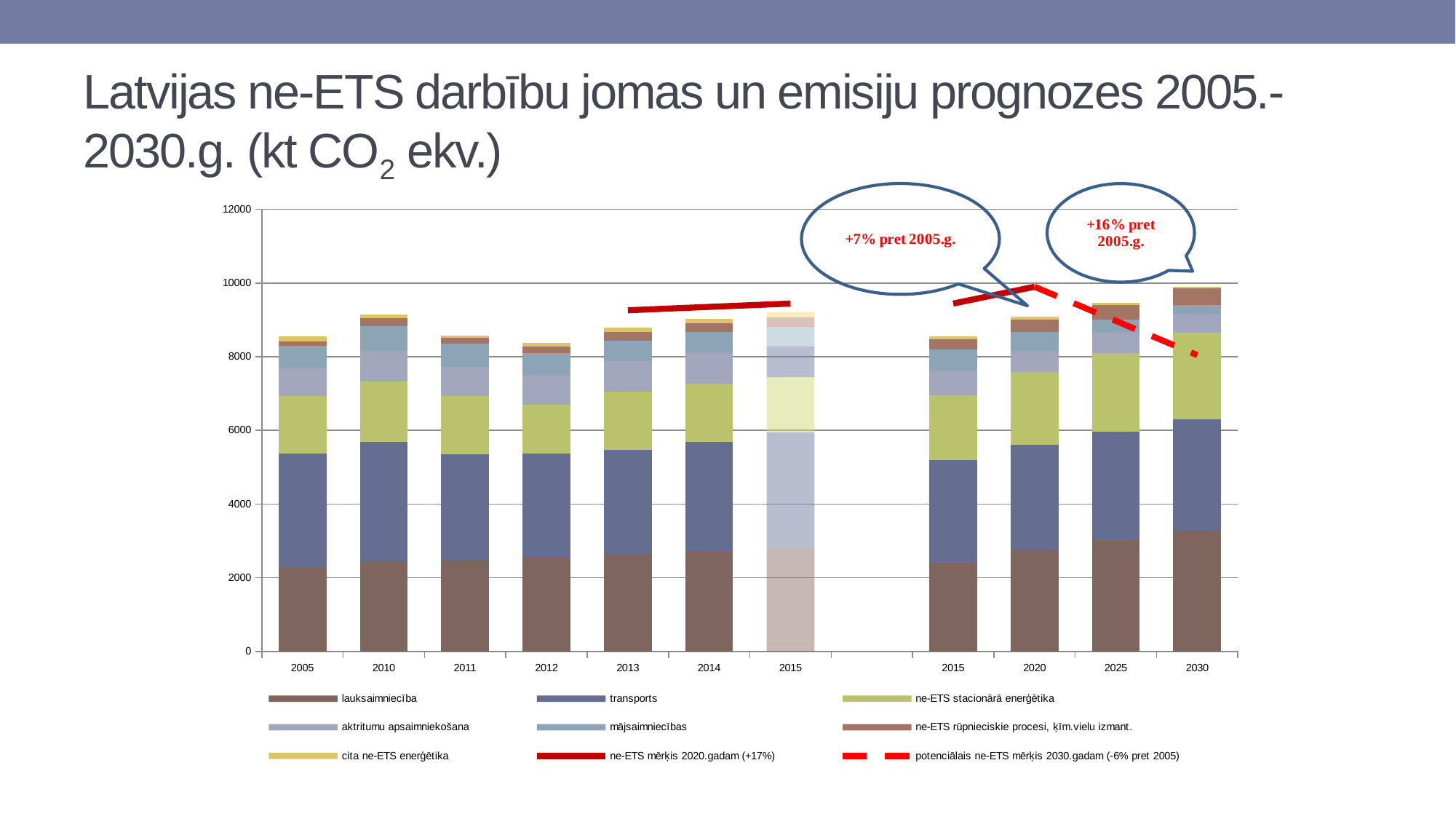
Is the top of the transports segment in the 2005 bar greater or less than 4000? greater Do the stacked bar totals rise or fall from 2015 to 2030 in the right-hand group of bars? rise How many entries does the legend list? 9 What kind of chart is shown on the slide? stacked bar chart What does the callout above the 2020 bar say? +7% pret 2005.g. Which is larger, the total stacked bar for 2030 or for 2005? 2030 How many bars (year categories) are plotted along the x axis? 11 Is the lauksaimniecība segment in the 2030 bar greater or less than 2000? greater Is the total stacked value for 2012 greater or less than 10000? less Which year has the tallest stacked bar? 2030